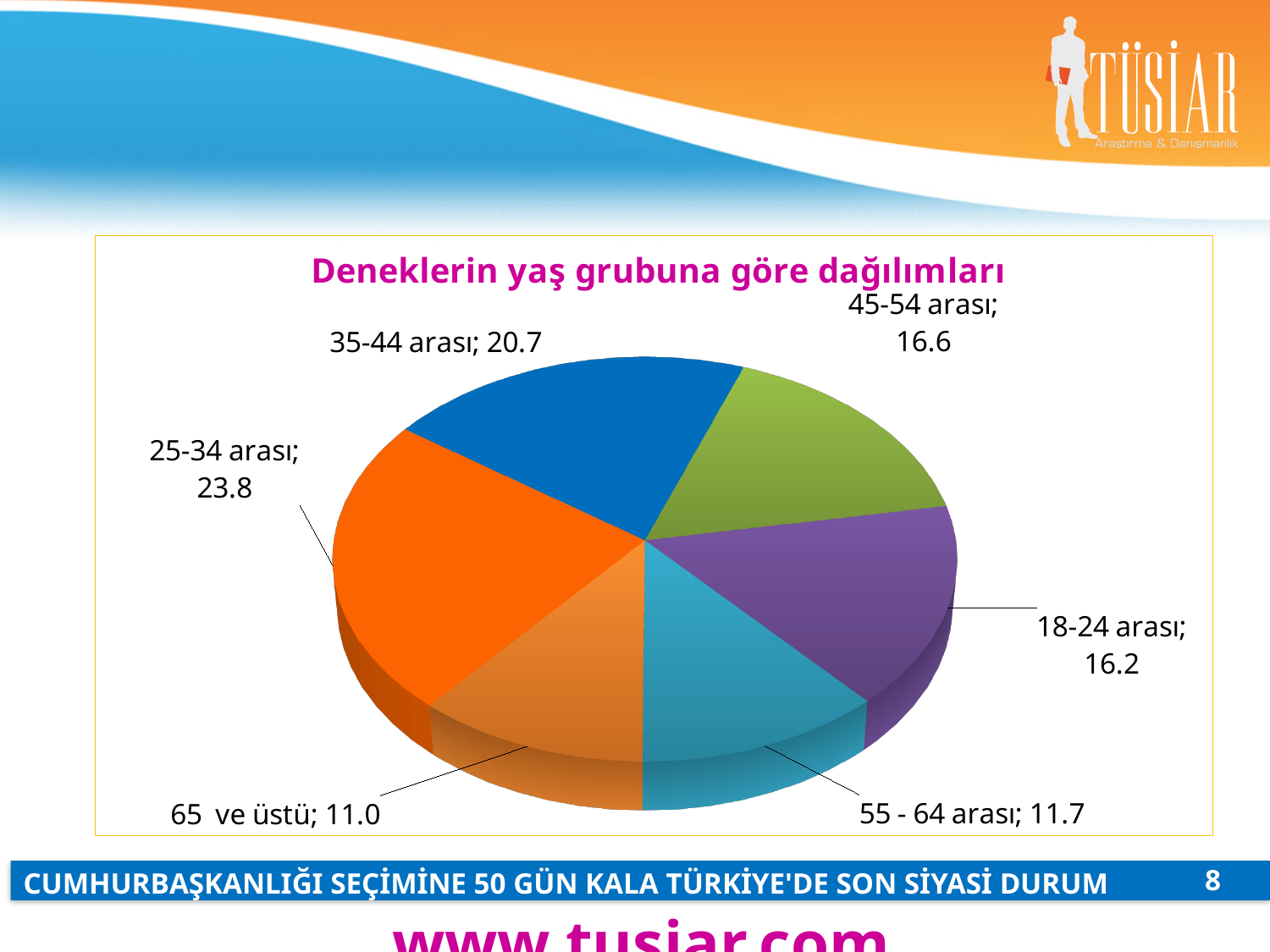
What is the difference between the values for 55 - 64 arası and 65 ve üstü? 0.7 What is the value for the 55 - 64 arası slice? 11.7 What is the value for the 18-24 arası slice? 16.2 What type of chart is shown on the slide? pie chart Which is larger, the value for 45-54 arası or the value for 55 - 64 arası? 45-54 arası What is the title of the chart? Deneklerin yaş grubuna göre dağılımları What is the difference between the values for 25-34 arası and 35-44 arası? 3.1 What is the value for the 25-34 arası slice? 23.8 Which age group has the smallest share of the pie? 65 ve üstü What is the value for the 35-44 arası slice? 20.7 Which age group has the largest share of the pie? 25-34 arası How many age-group slices does the pie chart have? 6